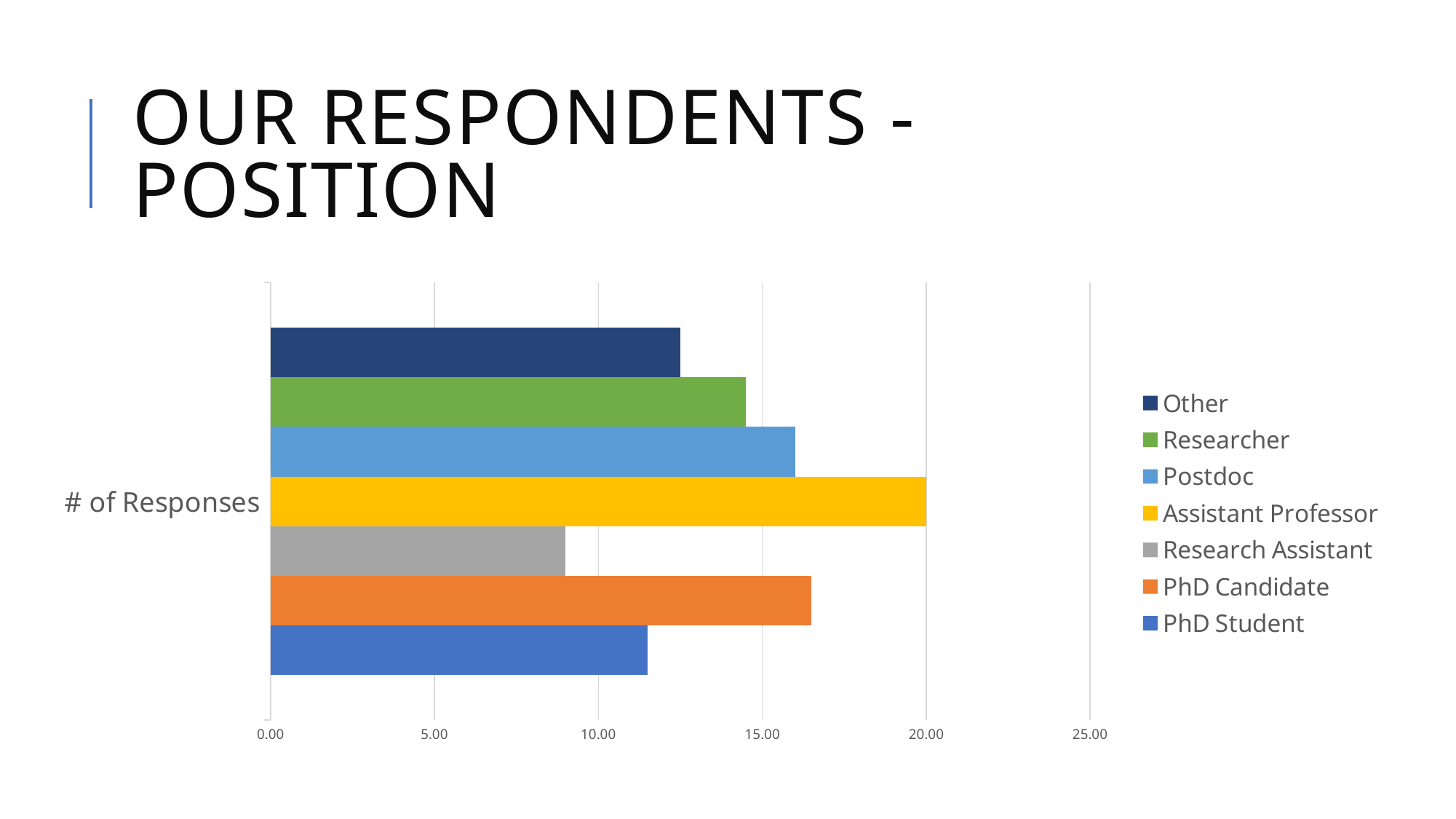
What kind of chart is shown on the slide? bar chart Is the value for Research Assistant greater or less than 10.00? less How many series does the legend list? 7 Which has more responses, PhD Student or Research Assistant? PhD Student Which position has the highest number of responses? Assistant Professor Which position has the lowest number of responses? Research Assistant Is the value for PhD Student greater or less than 10.00? greater Is the value for Other greater or less than 15.00? less Which has more responses, Researcher or Other? Researcher What is the value for Assistant Professor? 20.00 What colour is the bar for Assistant Professor? yellow